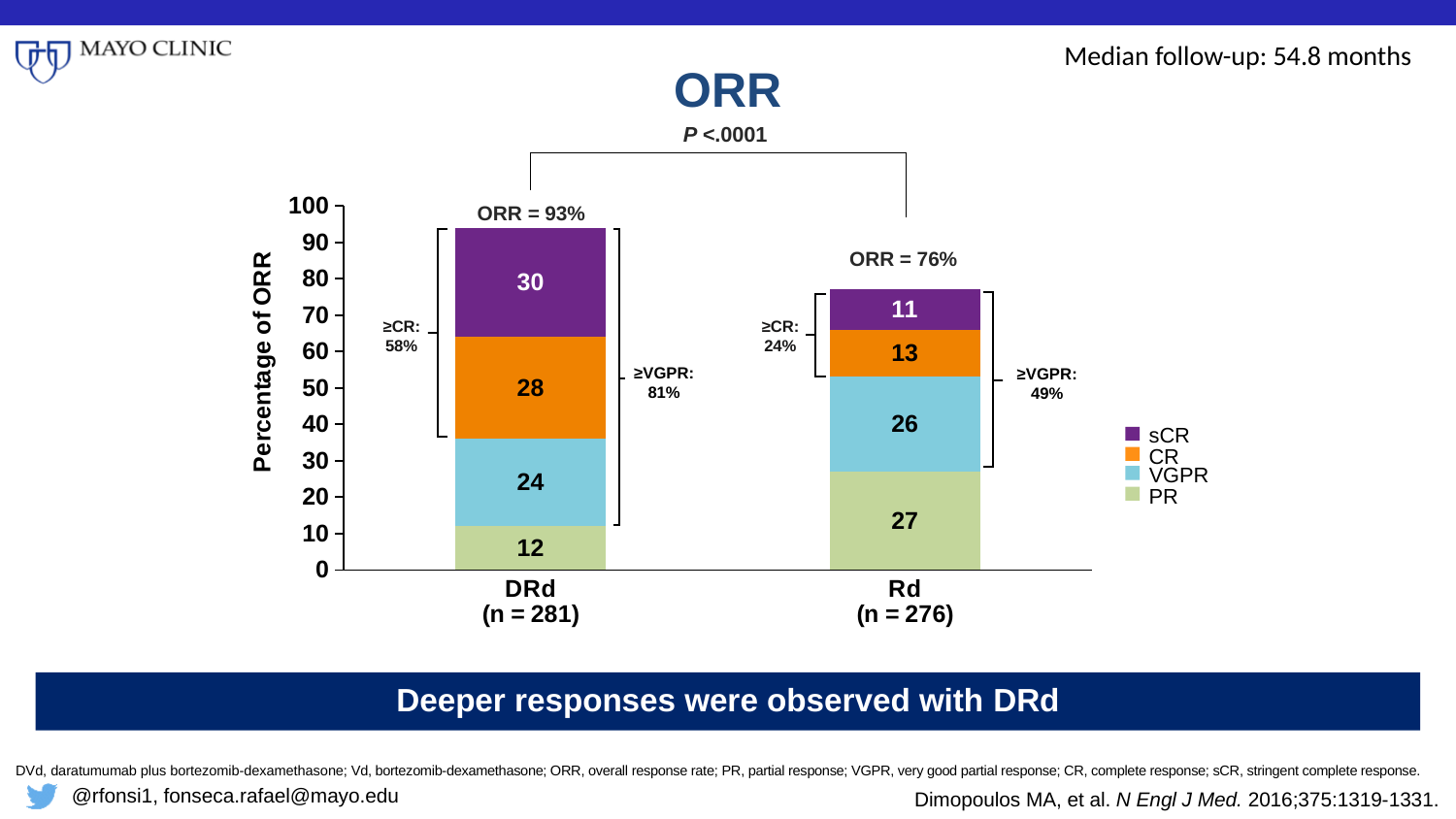
What ORR is labeled above the DRd bar? ORR = 93% What is the VGPR value for DRd? 24 Which group has the larger PR value, DRd or Rd? Rd What is the CR value for Rd? 13 What is the sCR value for DRd? 30 What type of chart is shown on the slide? Stacked bar chart What ORR is labeled above the Rd bar? ORR = 76% How many series does the legend list? 4 What is the PR value for Rd? 27 What is the ≥VGPR percentage annotated for the Rd bar? 49% What is the difference between the sCR values for DRd and Rd? 19 How many bars (treatment groups) are shown on the x axis? 2